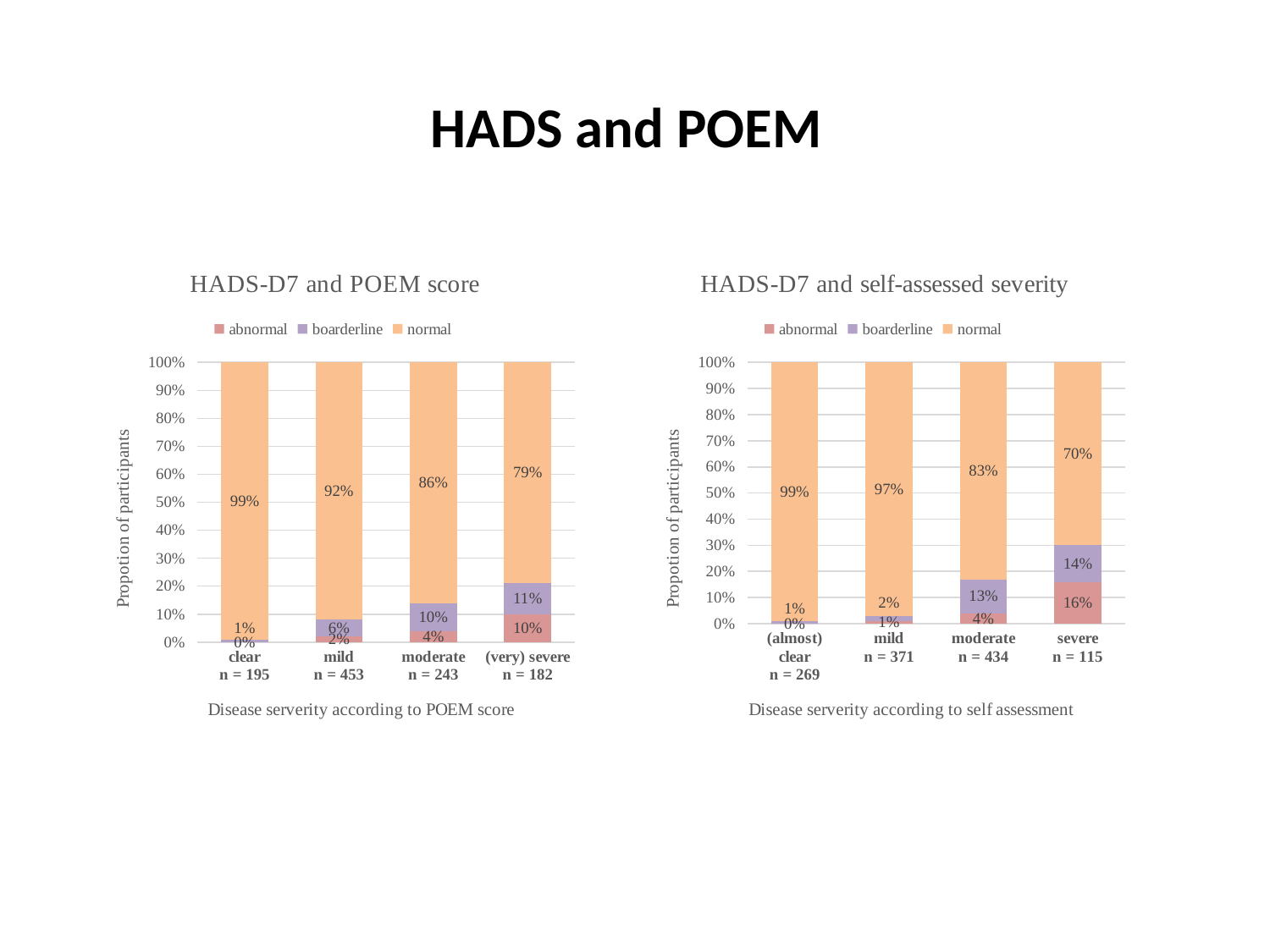
In the 'HADS-D7 and POEM score' chart, what is the abnormal percentage for the (very) severe group? 10% In the 'HADS-D7 and POEM score' chart, what percentage of participants in the moderate group are classified as normal? 86% In the 'HADS-D7 and POEM score' chart, which disease severity group has the lowest normal percentage? (very) severe How many series does the legend of the 'HADS-D7 and self-assessed severity' chart list? 3 In the 'HADS-D7 and POEM score' chart, what is the difference between the normal percentages of the clear and (very) severe groups? 20% How many disease severity groups are shown in the 'HADS-D7 and POEM score' chart? 4 In the 'HADS-D7 and self-assessed severity' chart, what percentage of the mild group is normal? 97% In the 'HADS-D7 and self-assessed severity' chart, does the normal percentage rise or fall as severity increases from (almost) clear to severe? fall What type of chart is the 'HADS-D7 and POEM score' chart? stacked bar chart In the 'HADS-D7 and self-assessed severity' chart, which group has the highest abnormal percentage? severe In the 'HADS-D7 and self-assessed severity' chart, what is the boarderline percentage for the severe group? 14% In the 'HADS-D7 and self-assessed severity' chart, is the abnormal percentage for the severe group larger or smaller than its boarderline percentage? larger